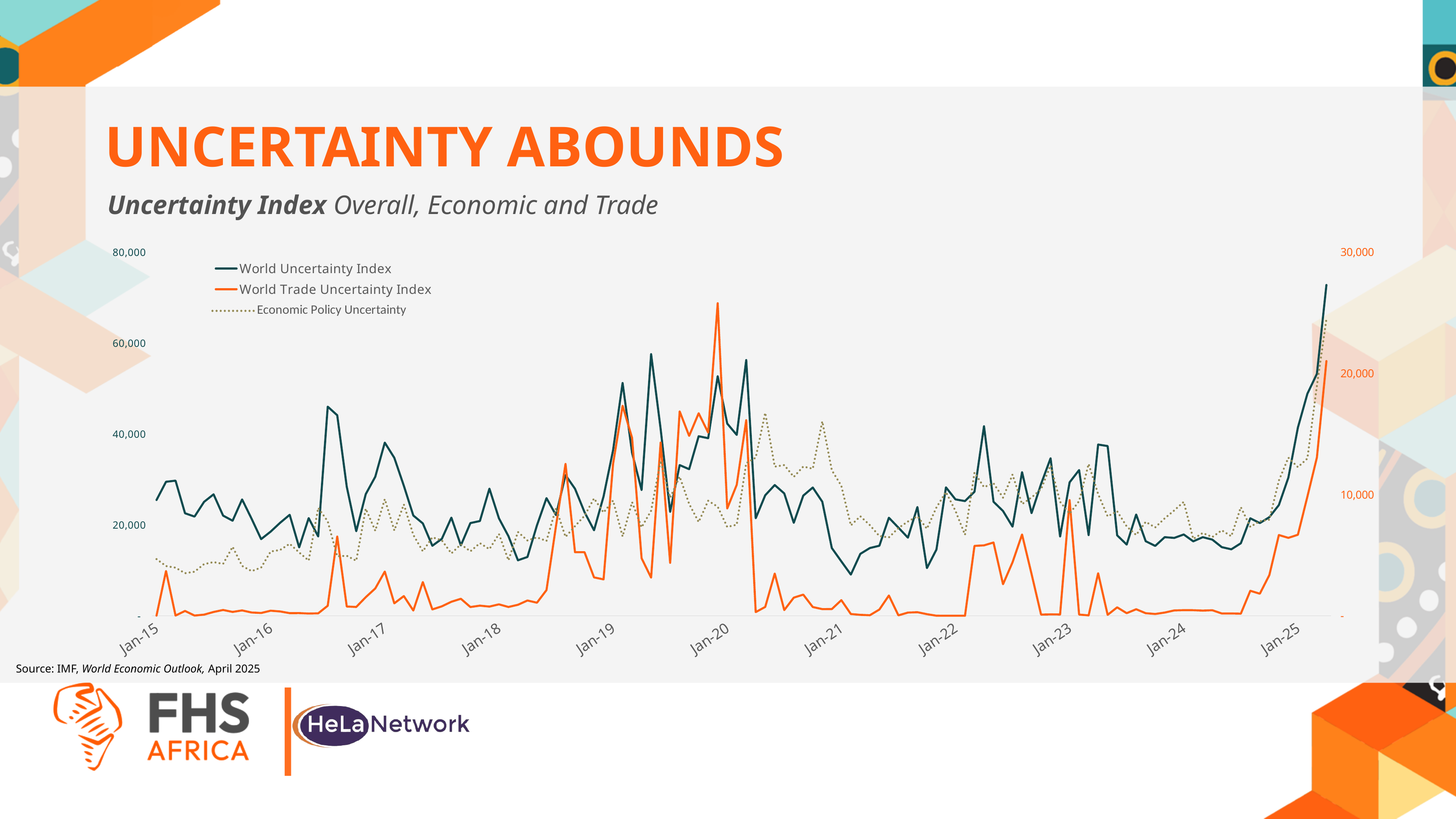
Near which x-axis label does the World Uncertainty Index reach its highest point? Jan-25 Does the World Uncertainty Index rise or fall between Jan-20 and Jan-21? fall Does the World Uncertainty Index rise or fall between Jan-24 and Jan-25? rise Is the World Uncertainty Index value at Jan-15 greater or less than 20,000 on the left axis? greater What is the subtitle of the chart on the slide? Uncertainty Index Overall, Economic and Trade Is the highest spike of the World Trade Uncertainty Index around Jan-20 greater or less than 20,000 on the right axis? greater Is the World Trade Uncertainty Index value at Jan-15 greater or less than 10,000 on the right axis? less What is the highest value shown on the right-hand vertical axis? 30,000 How many series does the chart's legend list? 3 How many year labels are shown along the x axis? 11 What kind of chart is shown on the slide? line chart